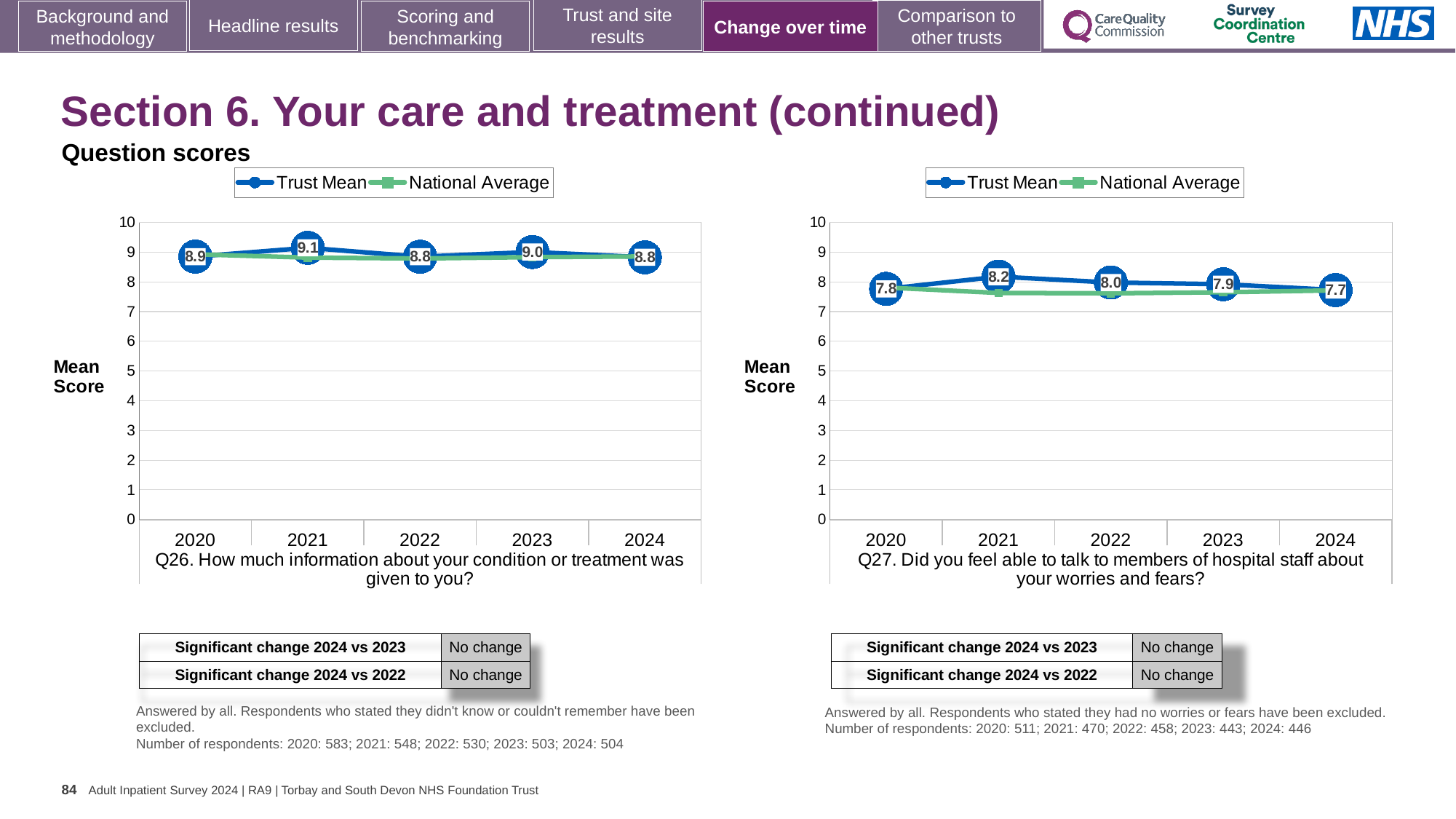
How many series does the legend of the Q26 chart on the left list? 2 In the Q26 chart on the left, is the National Average value for 2024 greater or less than 8? greater In the Q26 chart on the left, what is the difference between the Trust Mean scores for 2021 and 2024? 0.3 What type of chart is the Q26 chart on the left? Line chart In the Q27 chart on the right, what is the Trust Mean score for 2024? 7.7 In the Q26 chart on the left, what is the Trust Mean score for 2021? 9.1 In the Q27 chart on the right, which year has the lowest Trust Mean score? 2024 In the Q27 chart on the right, what is the difference between the Trust Mean scores for 2021 and 2024? 0.5 In the Q27 chart on the right, which year has the highest Trust Mean score? 2021 In the Q27 chart on the right, is the Trust Mean score higher in 2020 or in 2021? 2021 In the Q26 chart on the left, which year has the highest Trust Mean score? 2021 How many years are shown on the x axis of the Q27 chart on the right? 5